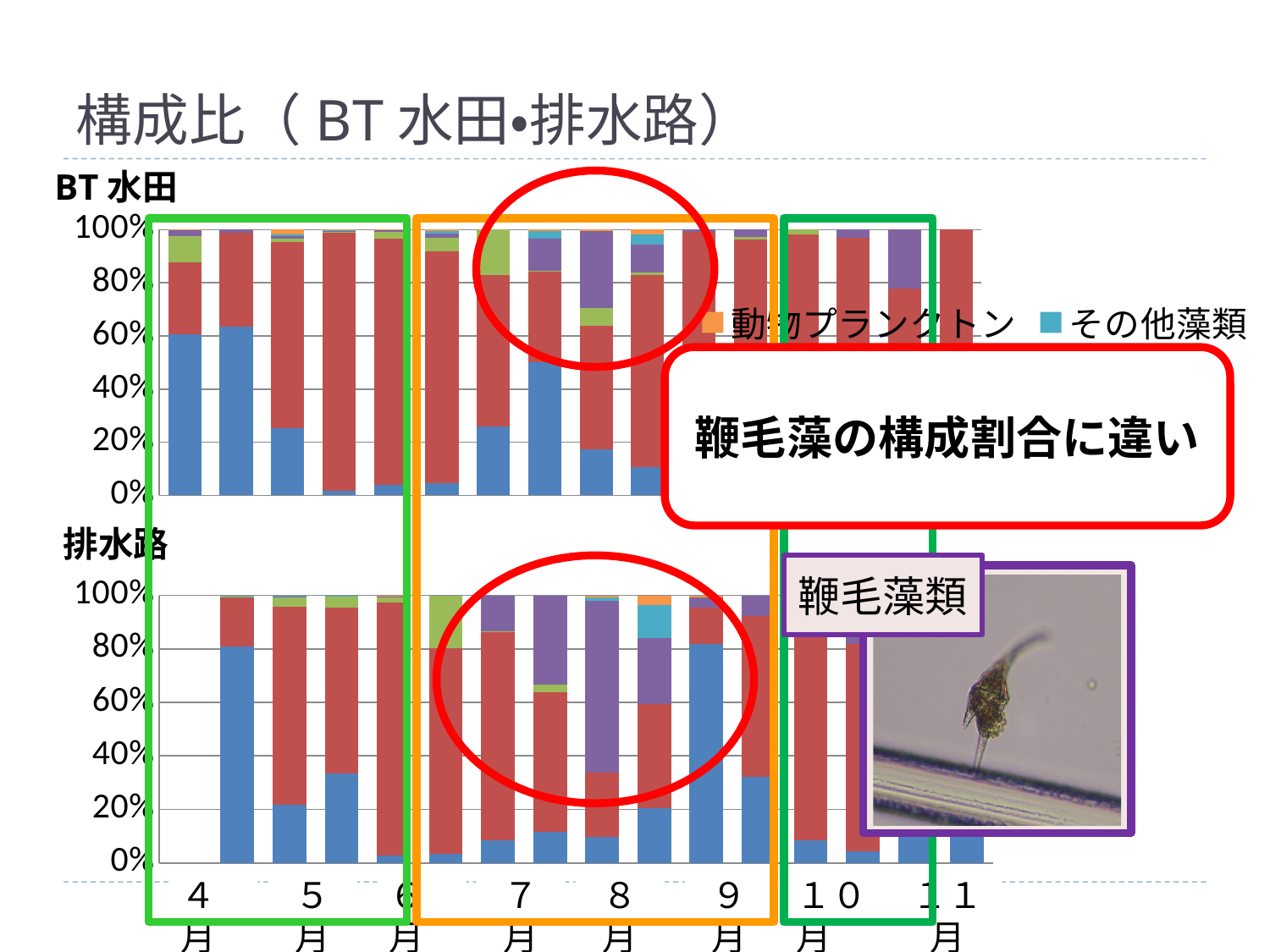
In the BT水田 chart, is the blue segment of the first bar for 4月 greater or less than 40%? greater In the 排水路 chart, which has the larger blue segment: the bar for 4月 or the first bar for 5月? the bar for 4月 Which colour represents 動物プランクトン in the legend? orange In the 排水路 chart, is the blue segment of the first bar for 5月 greater or less than 40%? less In the BT水田 chart, which has the larger blue segment: the first bar for 4月 or the first bar for 5月? the first bar for 4月 What kind of chart is the BT水田 chart at the top of the slide? stacked bar chart What kind of chart is the 排水路 chart at the bottom of the slide? stacked bar chart What is the highest value shown on the y axis of the BT水田 chart? 100% In the 排水路 chart, is the blue segment of the bar for 4月 greater or less than 60%? greater